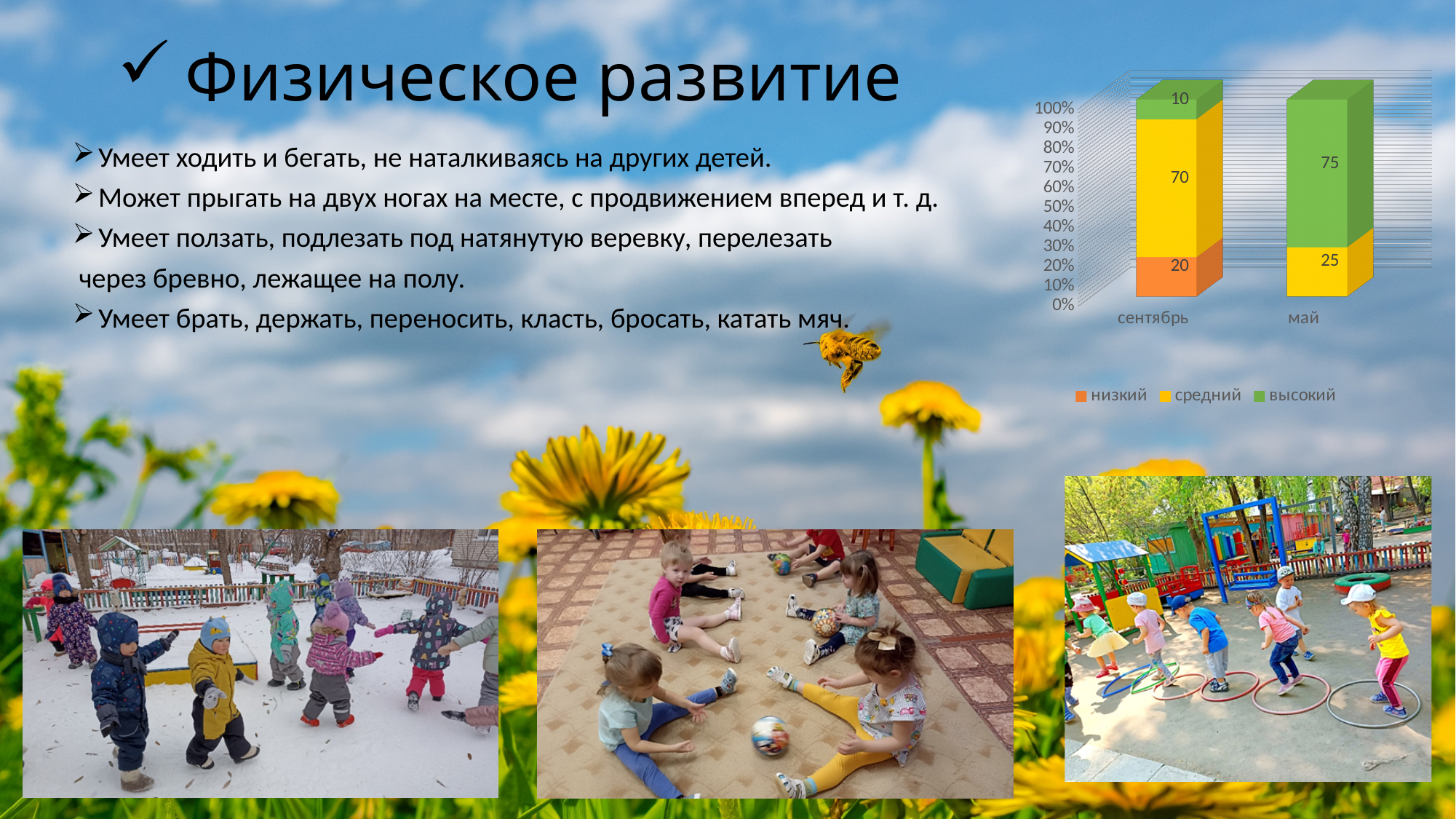
Which category has the higher value for the высокий series, сентябрь or май? май How many categories are shown on the x axis of the chart? 2 What is the difference between the высокий values for май and сентябрь? 65 What is the value of the высокий series for май? 75 What is the value of the средний series for сентябрь? 70 How many series does the chart legend list? 3 Does the value of the высокий series rise or fall from сентябрь to май? rise What is the value of the средний series for май? 25 What is the value of the высокий series for сентябрь? 10 What is the value of the низкий series for сентябрь? 20 Which series is shown in orange in the chart legend? низкий What type of chart is shown on the slide? stacked bar chart